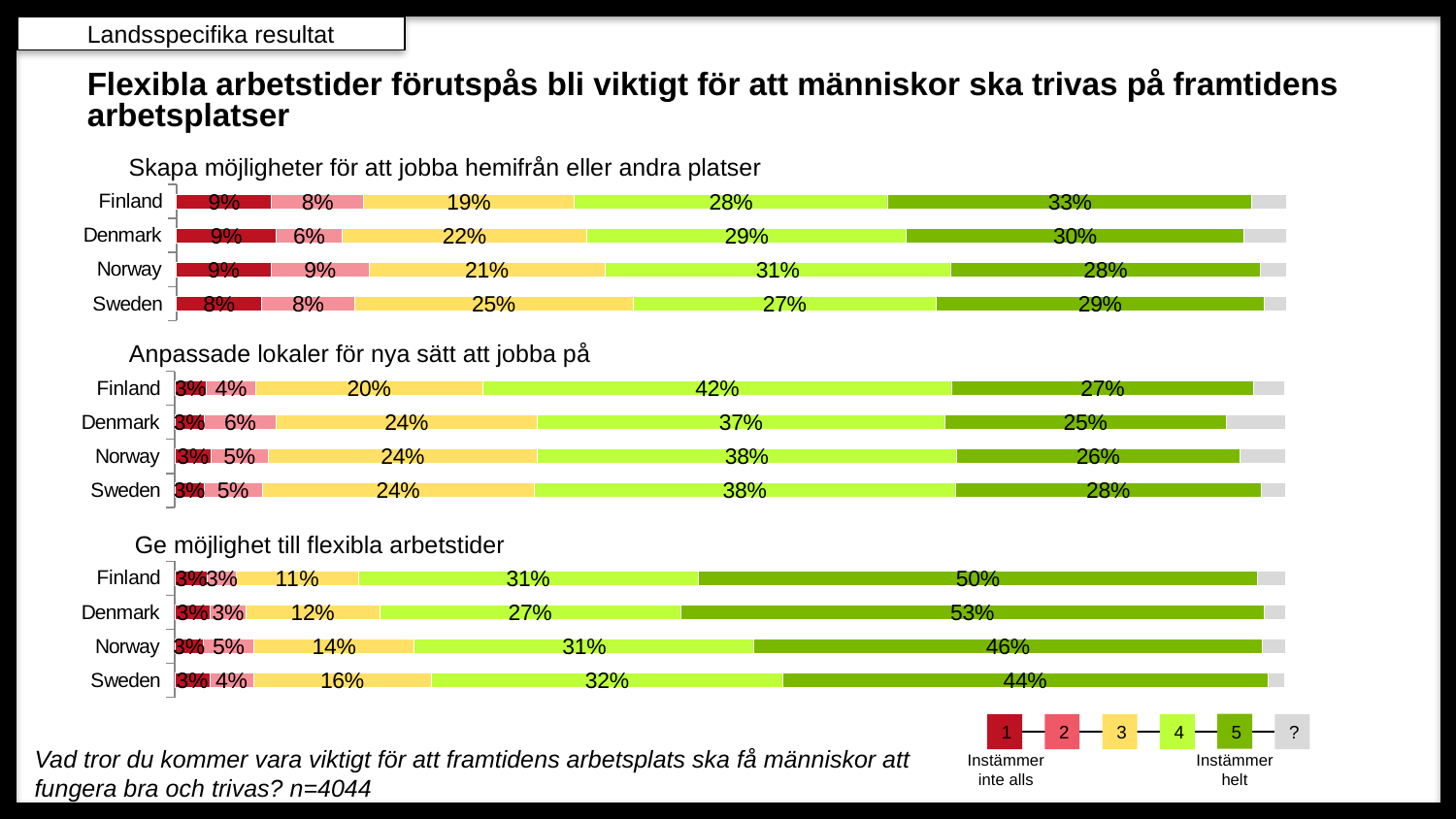
In the chart 'Anpassade lokaler för nya sätt att jobba på', which country has the lowest share answering 5 (Instämmer helt)? Denmark How many countries are shown in the chart 'Anpassade lokaler för nya sätt att jobba på'? 4 In the chart 'Ge möjlighet till flexibla arbetstider', which country has the lowest share answering 5 (Instämmer helt)? Sweden In the chart 'Anpassade lokaler för nya sätt att jobba på', what percentage of respondents in Finland answered 4? 42% In the chart 'Skapa möjligheter för att jobba hemifrån eller andra platser', what percentage of respondents in Norway answered 4? 31% In the chart 'Skapa möjligheter för att jobba hemifrån eller andra platser', which is larger: Sweden's share answering 3 or Finland's share answering 3? Sweden's share answering 3 In the chart 'Ge möjlighet till flexibla arbetstider', which country has the highest share answering 5 (Instämmer helt)? Denmark How many entries does the legend at the bottom of the slide list? 6 What kind of chart is used for 'Ge möjlighet till flexibla arbetstider'? Stacked bar chart In the chart 'Ge möjlighet till flexibla arbetstider', what is the difference between Denmark's and Sweden's share answering 5? 9% In the chart 'Skapa möjligheter för att jobba hemifrån eller andra platser', what percentage of respondents in Finland answered 5 (Instämmer helt)? 33% Which legend label is shown under the value 1 at the bottom of the slide? Instämmer inte alls